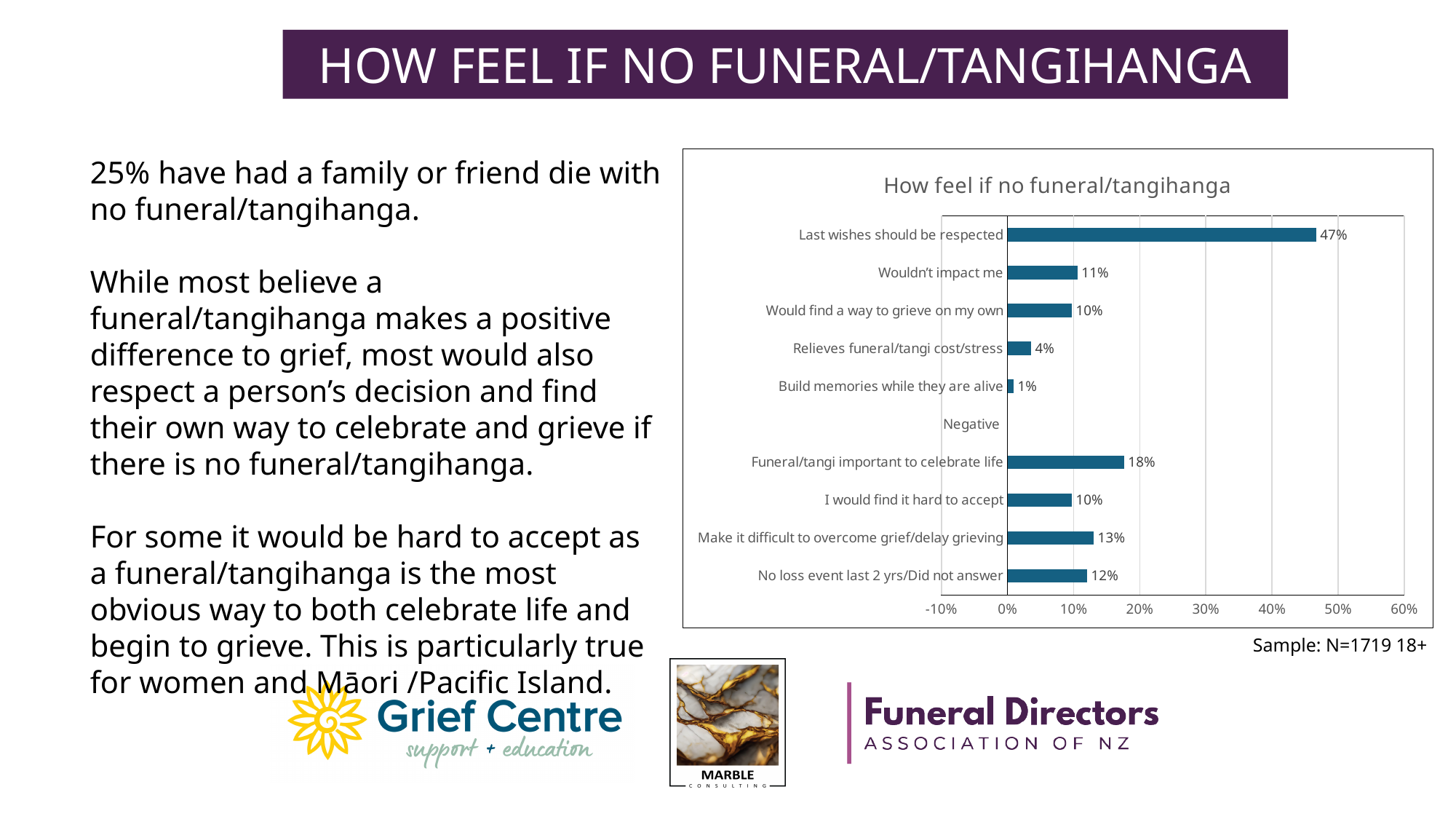
What type of chart is shown on the slide? Bar chart Is the value for 'Last wishes should be respected' greater or less than 40%? greater What is the value for 'Funeral/tangi important to celebrate life'? 18% What percentage of respondents said 'Last wishes should be respected'? 47% What is the value for 'Relieves funeral/tangi cost/stress'? 4% What is the difference between 'Last wishes should be respected' and 'Funeral/tangi important to celebrate life'? 29% Which is larger: 'Wouldn't impact me' or 'No loss event last 2 yrs/Did not answer'? No loss event last 2 yrs/Did not answer How many bars are plotted in the chart? 9 What percentage is shown for 'Make it difficult to overcome grief/delay grieving'? 13% Which category has the highest value in the chart? Last wishes should be respected What is the title of the chart? How feel if no funeral/tangihanga Which category with a plotted bar has the lowest value? Build memories while they are alive